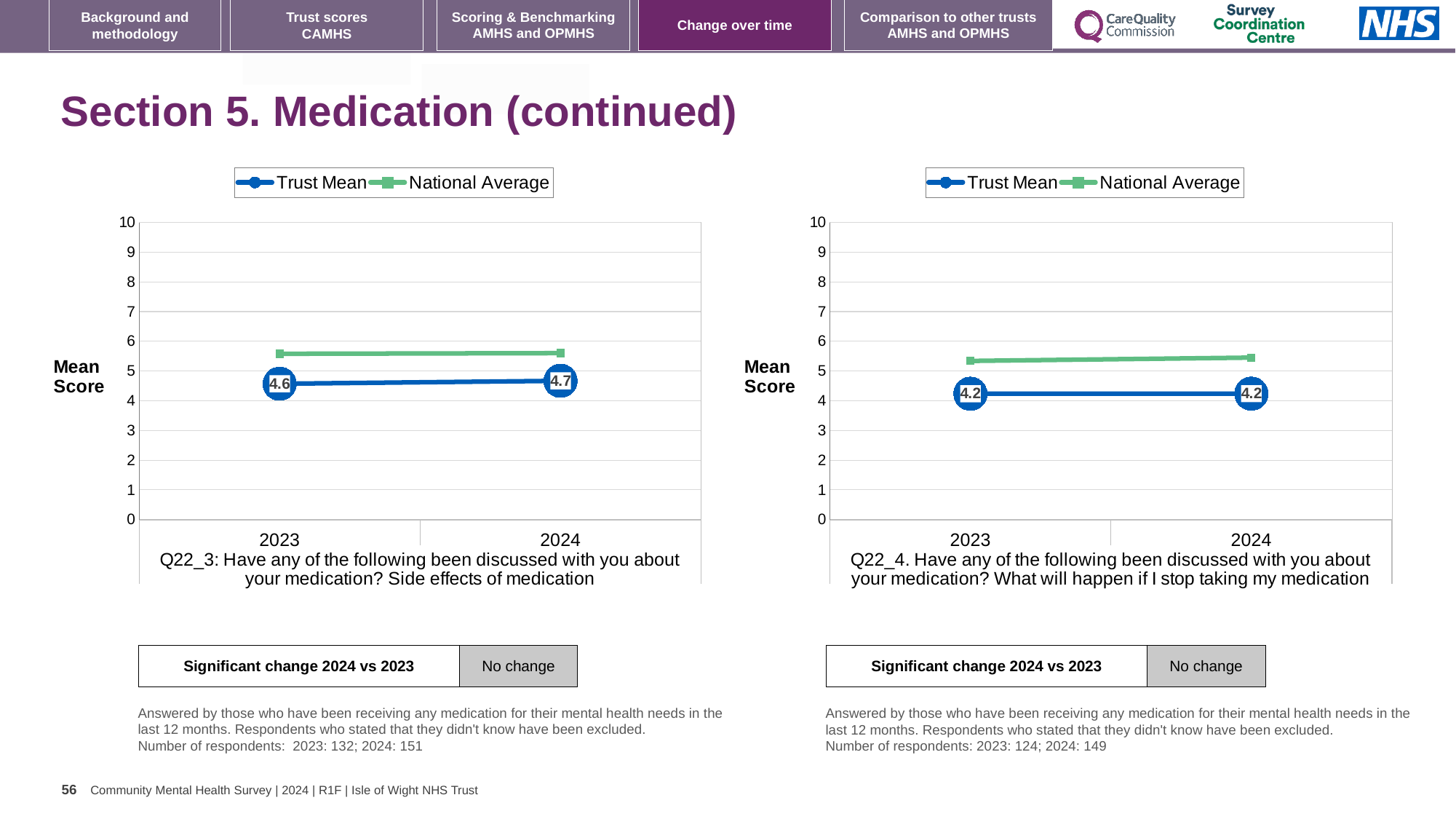
In the right chart (Q22_4), what is the Trust Mean for 2024? 4.2 How many series does the legend of the left chart list? 2 In the left chart (Q22_3), what is the Trust Mean for 2024? 4.7 In the left chart (Q22_3), does the Trust Mean rise or fall from 2023 to 2024? rise In the left chart (Q22_3), what is the Trust Mean for 2023? 4.6 In the right chart (Q22_4), which is higher in 2024, the Trust Mean or the National Average? National Average In the right chart (Q22_4), does the Trust Mean rise, fall or stay the same from 2023 to 2024? stay the same In the right chart (Q22_4), is the National Average for 2023 greater or less than 6? less How many years are shown on the x axis of the right chart? 2 In the left chart (Q22_3), by how much did the Trust Mean change from 2023 to 2024? 0.1 What type of chart is the left chart (Q22_3)? line chart In the left chart (Q22_3), is the National Average for 2024 greater or less than 5? greater